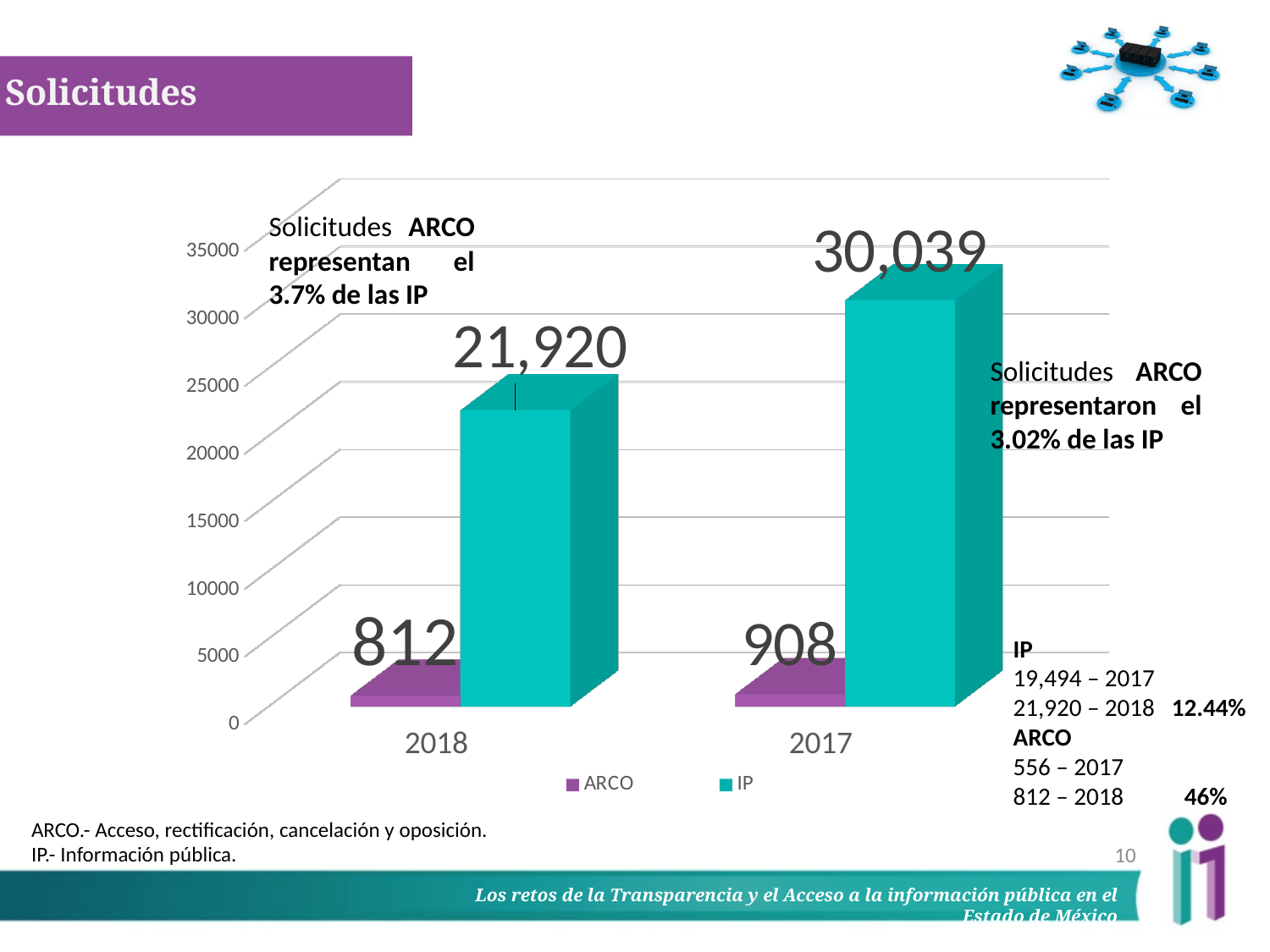
Is the IP value for 2018 greater or less than 20000? greater What kind of chart is shown on the slide? Bar chart What is the difference between the ARCO values for 2017 and 2018? 96 What is the value for IP in 2017? 30,039 What is the value for ARCO in 2017? 908 What is the value for IP in 2018? 21,920 Which year has the lower ARCO value? 2018 What is the difference between the IP values for 2017 and 2018? 8,119 Which colour represents the IP series in the chart? Teal What is the value for ARCO in 2018? 812 How many series does the legend list? 2 Which year has the higher IP value? 2017